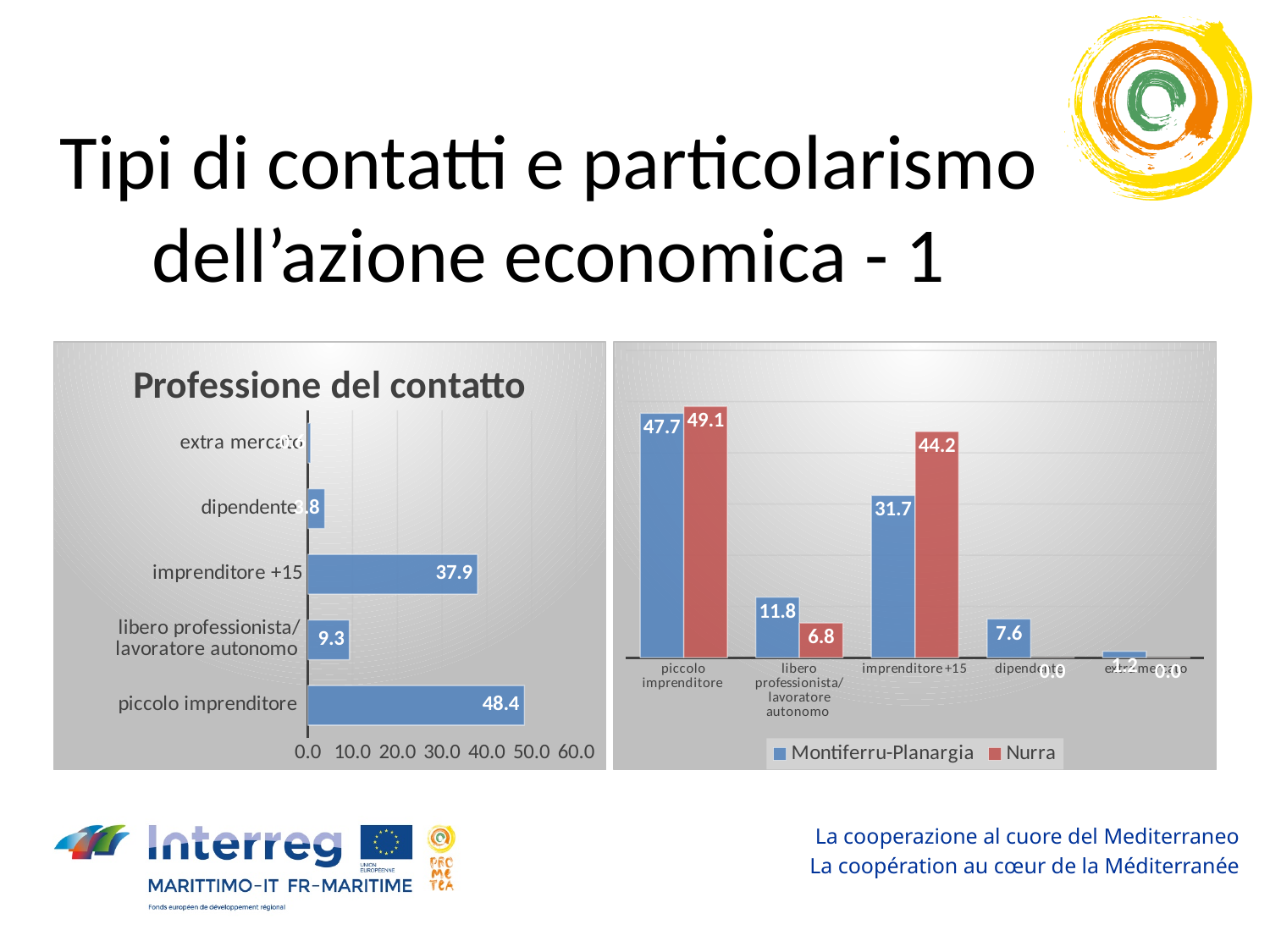
In the left chart titled 'Professione del contatto', what is the value for imprenditore +15? 37.9 In the right chart, which is larger for imprenditore +15: Montiferru-Planargia or Nurra? Nurra In the right chart, which category has the highest value for Nurra? piccolo imprenditore In the left chart titled 'Professione del contatto', which category has the highest value? piccolo imprenditore What kind of chart is the left chart titled 'Professione del contatto'? bar chart In the left chart titled 'Professione del contatto', what is the difference between the values for piccolo imprenditore and imprenditore +15? 10.5 In the left chart titled 'Professione del contatto', how many categories are shown? 5 In the left chart titled 'Professione del contatto', what is the value for piccolo imprenditore? 48.4 In the right chart, what is the value for Nurra for imprenditore +15? 44.2 In the right chart, how many series does the legend list? 2 In the right chart, what is the value for Montiferru-Planargia for libero professionista/lavoratore autonomo? 11.8 In the right chart, what is the difference between the Montiferru-Planargia and Nurra values for libero professionista/lavoratore autonomo? 5.0